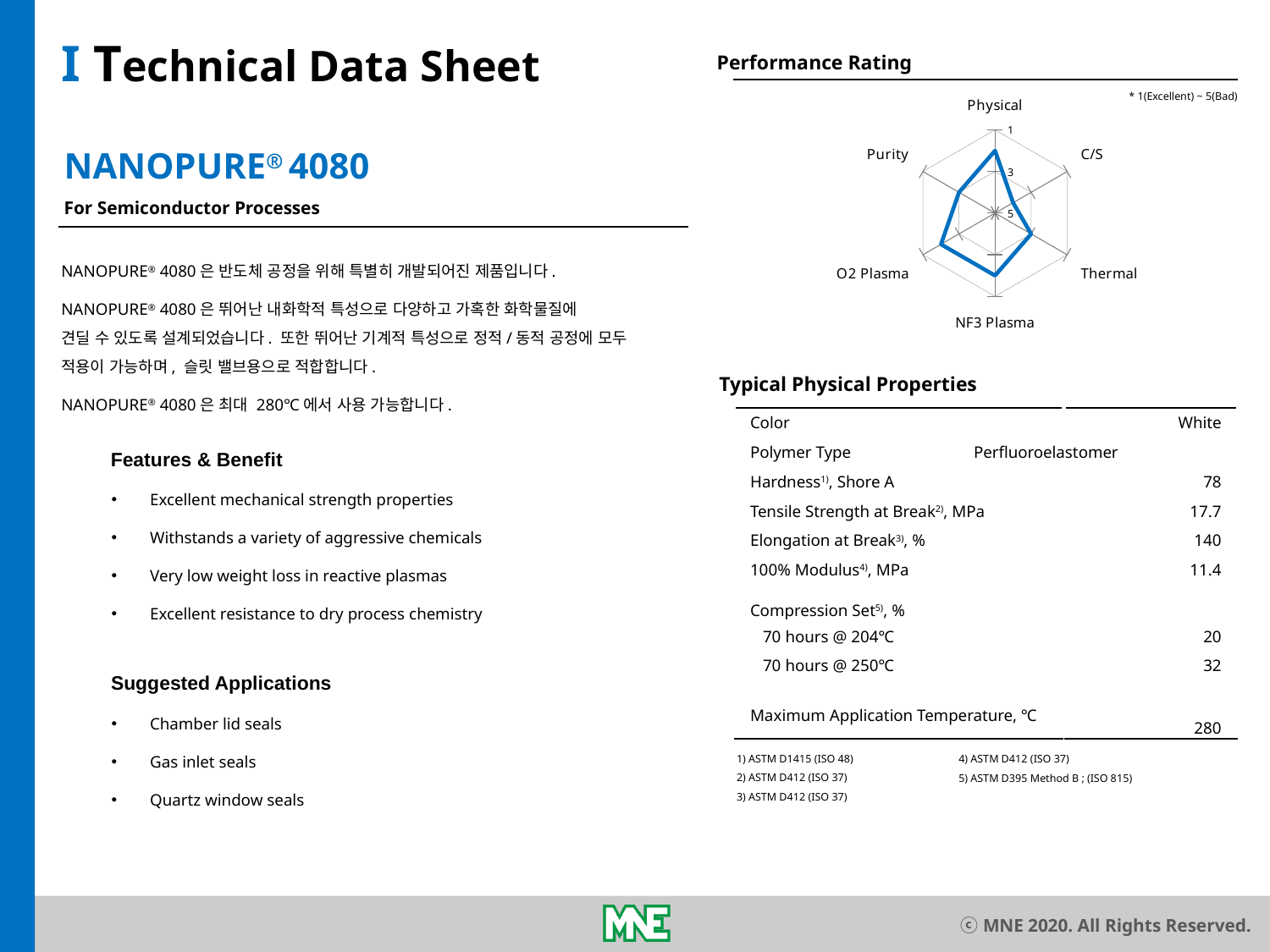
In the Performance Rating chart, which has the larger rating value, C/S or O2 Plasma? C/S In the Performance Rating chart, is the rating value for Physical greater or less than 3? less What kind of chart is shown under the heading "Performance Rating"? Radar chart What colour is the data line in the Performance Rating radar chart? Blue In the Performance Rating chart, is the rating value for C/S greater or less than 3? greater In the Performance Rating chart, which category has the highest (worst) rating value? C/S In the Performance Rating chart, is the rating value for O2 Plasma greater or less than 3? less What rating scale is noted next to the Performance Rating chart? 1(Excellent) ~ 5(Bad) In the Performance Rating chart, which has the larger rating value, C/S or Physical? C/S How many categories (axes) does the Performance Rating radar chart have? 6